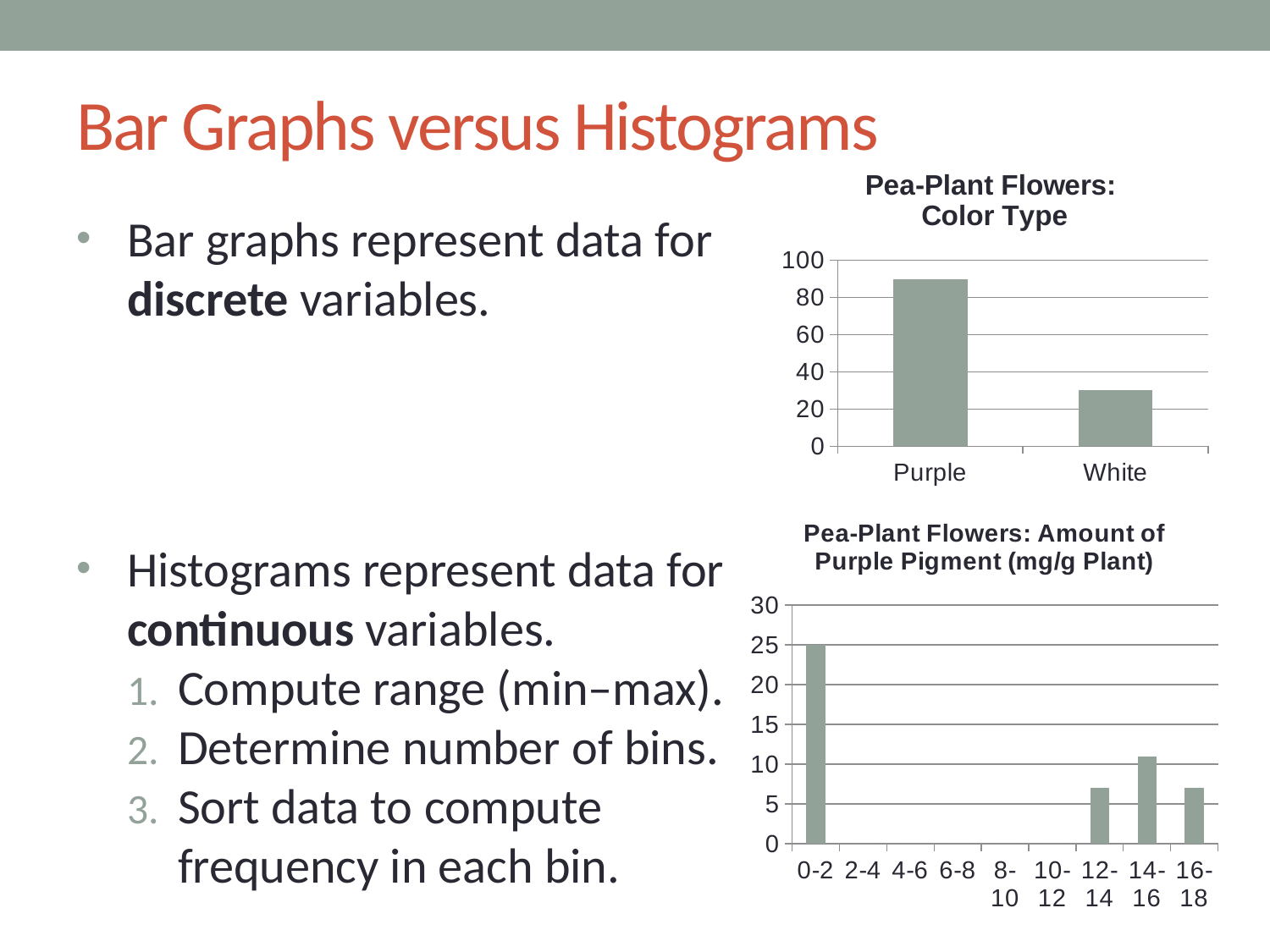
In the 'Pea-Plant Flowers: Color Type' chart, which category has the lowest value? White In the 'Pea-Plant Flowers: Amount of Purple Pigment (mg/g Plant)' chart, is the value for the 16-18 bin greater or less than 10? less How many bins are shown on the x axis of the 'Pea-Plant Flowers: Amount of Purple Pigment (mg/g Plant)' chart? 9 In the 'Pea-Plant Flowers: Color Type' chart, is the value for Purple greater or less than 80? greater In the 'Pea-Plant Flowers: Color Type' chart, is the value for White greater or less than 40? less In the 'Pea-Plant Flowers: Amount of Purple Pigment (mg/g Plant)' chart, which is larger, the value for 14-16 or the value for 12-14? 14-16 How many categories are shown in the 'Pea-Plant Flowers: Color Type' chart? 2 What kind of chart is the 'Pea-Plant Flowers: Color Type' chart? bar chart In the 'Pea-Plant Flowers: Amount of Purple Pigment (mg/g Plant)' chart, what is the value for the 0-2 bin? 25 In the 'Pea-Plant Flowers: Amount of Purple Pigment (mg/g Plant)' chart, which bin has the highest value? 0-2 In the 'Pea-Plant Flowers: Color Type' chart, which category has the highest value? Purple